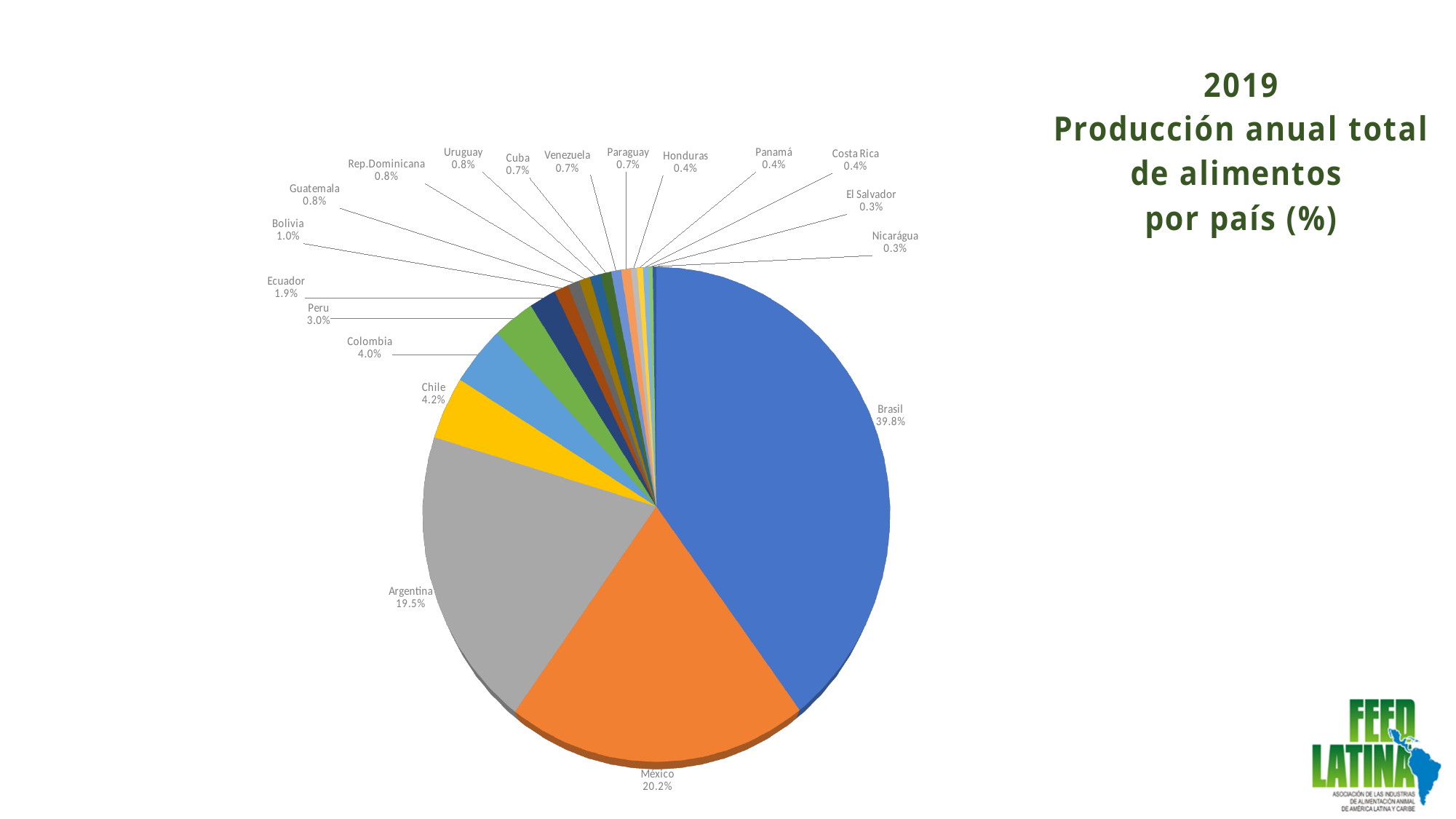
Which is larger, the share for Chile or the share for Colombia? Chile What is the value shown for Argentina? 19.5% What is the value shown for Ecuador? 1.9% Which is larger, the share for México or the share for Argentina? México What is the value shown for Peru? 3.0% Which country has the largest share of the pie? Brasil How many countries are shown in the pie chart? 19 What kind of chart is shown on the slide? Pie chart What year does the chart title refer to? 2019 What is the value shown for México? 20.2% What is the difference in percentage points between Brasil and México? 19.6 What share of the pie does Brasil account for? 39.8%